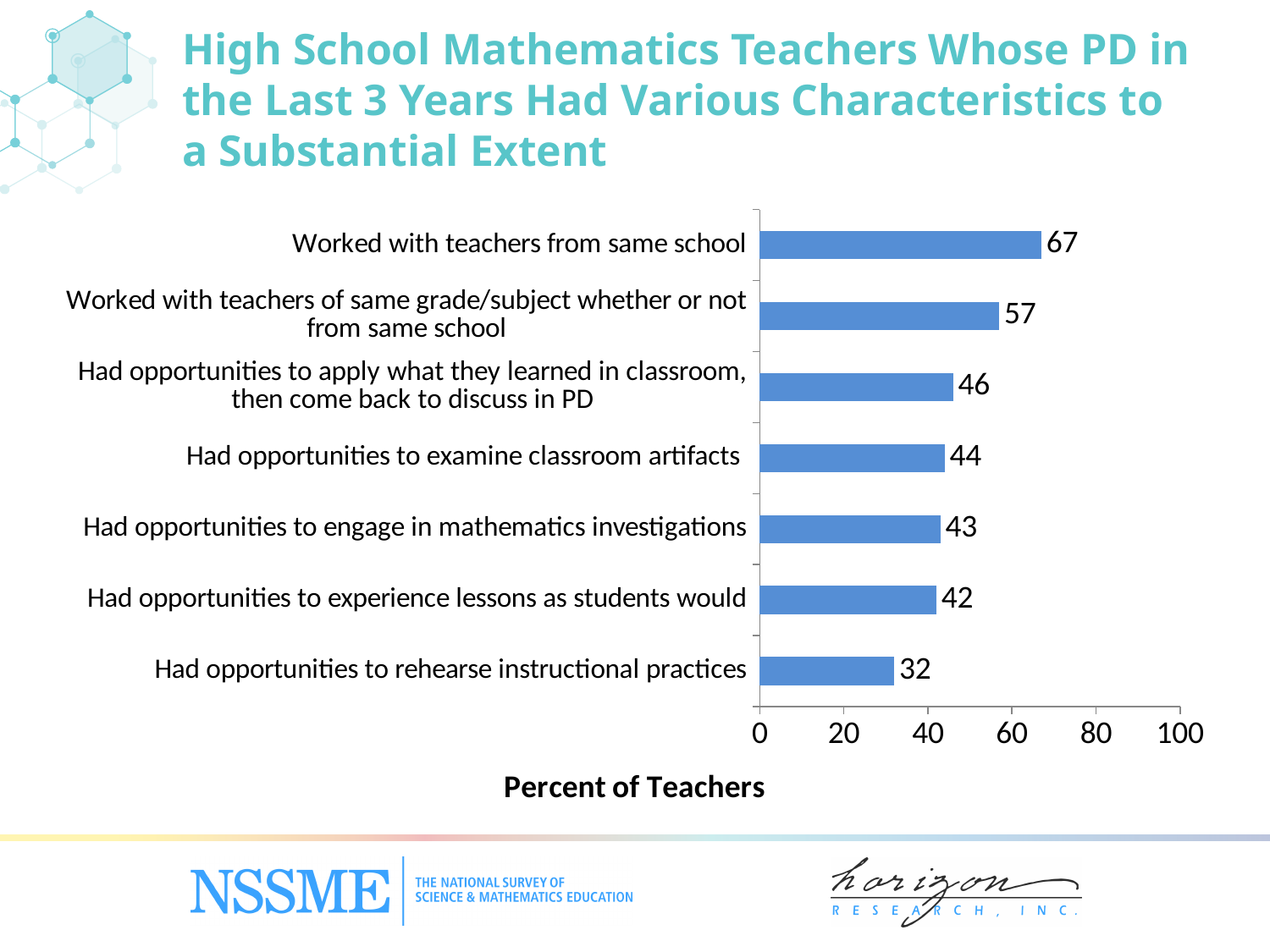
How many categories are shown in the chart? 7 Is the value for 'Had opportunities to engage in mathematics investigations' greater or less than 40? greater Which is larger: 'Had opportunities to apply what they learned in classroom, then come back to discuss in PD' or 'Had opportunities to experience lessons as students would'? Had opportunities to apply what they learned in classroom, then come back to discuss in PD What is the label of the horizontal axis? Percent of Teachers Which category has the lowest value? Had opportunities to rehearse instructional practices What is the value for 'Had opportunities to rehearse instructional practices'? 32 What is the value for 'Had opportunities to examine classroom artifacts'? 44 What kind of chart is shown on the slide? bar chart What percent of teachers worked with teachers from the same school? 67 Which category has the highest value? Worked with teachers from same school What is the maximum value shown on the horizontal axis? 100 What is the difference between 'Worked with teachers from same school' and 'Worked with teachers of same grade/subject whether or not from same school'? 10